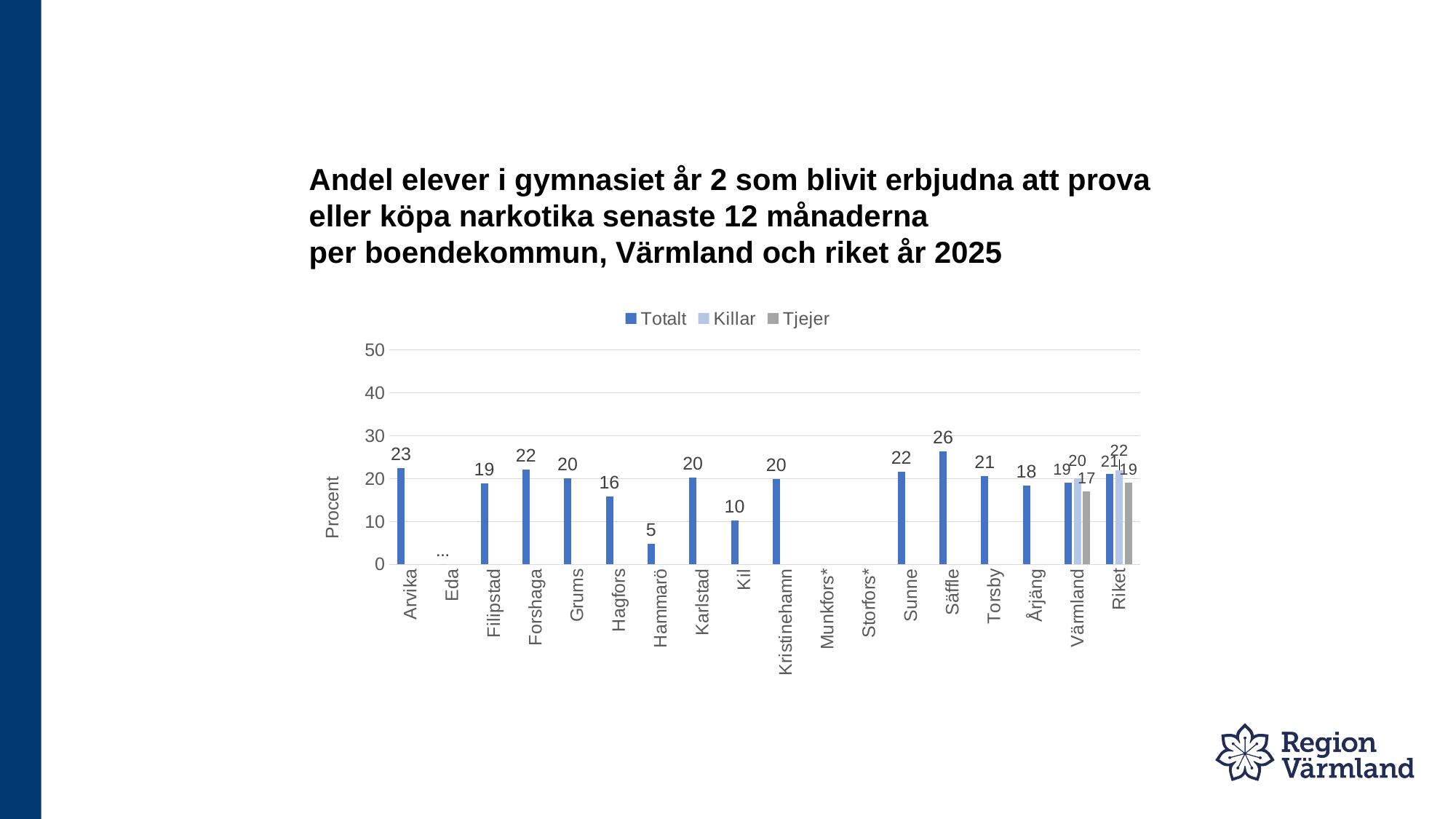
What is the Tjejer value for Värmland? 17 What kind of chart is shown on the slide? Bar chart Among the municipalities with a plotted bar, which has the lowest Totalt value? Hammarö What is the Totalt value for Hammarö? 5 Which municipality has the highest Totalt value? Säffle How many series does the legend list? 3 What is the label of the y axis? Procent What is the Totalt value for Säffle? 26 What is the Killar value for Riket? 22 What is the difference between the Totalt values for Arvika and Kil? 13 Which has a higher Totalt value, Hagfors or Forshaga? Forshaga How many categories are shown on the x axis? 18